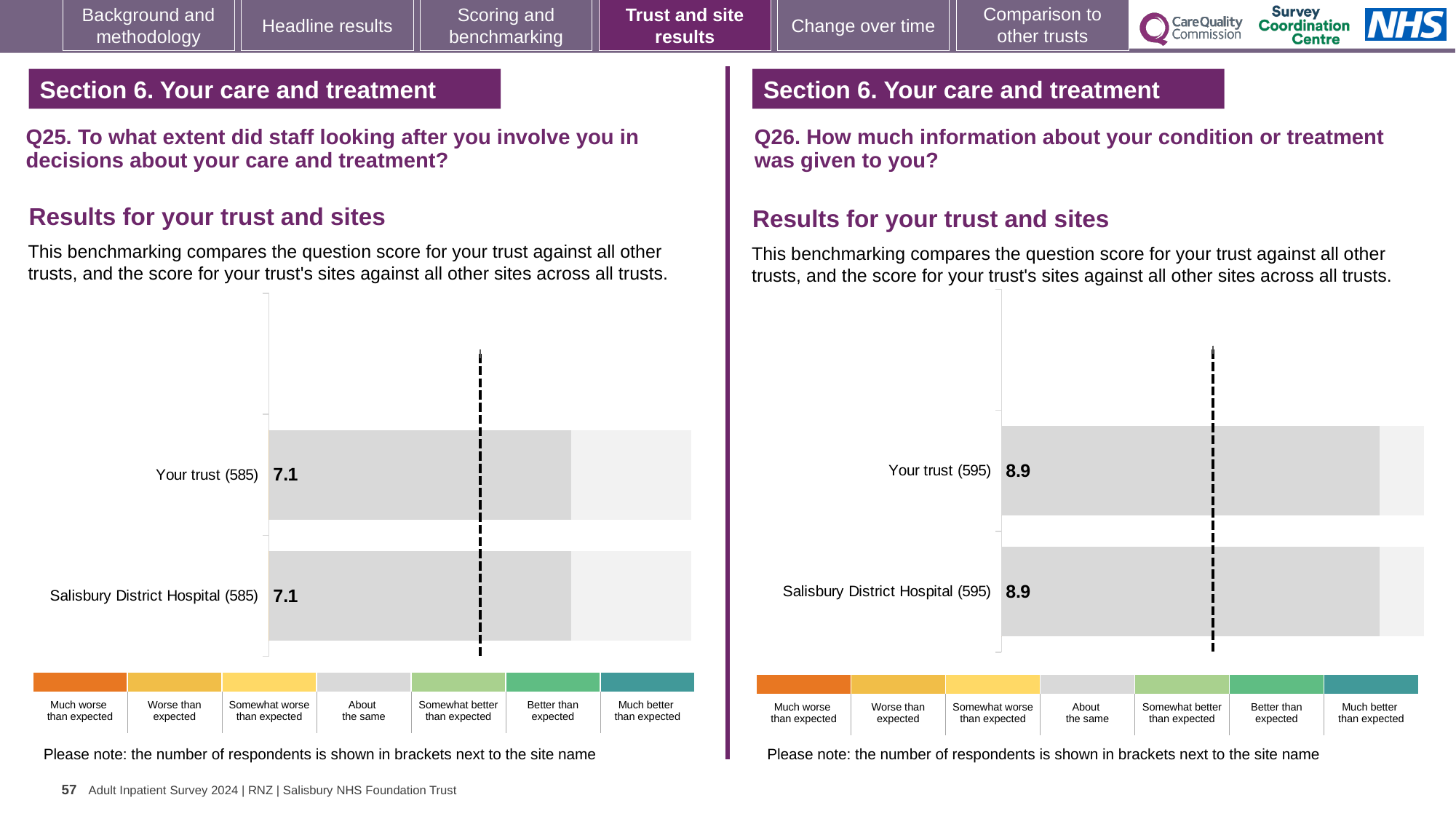
What kind of chart is used for the Q25 results on the left? Bar chart In the Q26 chart on the right, how many respondents are shown in brackets next to Salisbury District Hospital? 595 In the Q25 chart on the left, how many respondents are shown in brackets next to Your trust? 585 In the Q26 chart on the right, what is the score for Salisbury District Hospital? 8.9 How many benchmark categories does the colour key below the Q26 chart on the right list? 7 In the Q26 chart on the right, what is the score for Your trust? 8.9 In the Q25 chart on the left, what is the difference between the score for Your trust and the score for Salisbury District Hospital? 0 In the Q25 chart on the left, what is the score for Your trust? 7.1 In the Q25 chart on the left, what is the score for Salisbury District Hospital? 7.1 How many bars are plotted in the Q25 chart on the left? 2 In the Q26 chart on the right, what is the difference between the score for Your trust and the score for Salisbury District Hospital? 0 How many bars are plotted in the Q26 chart on the right? 2